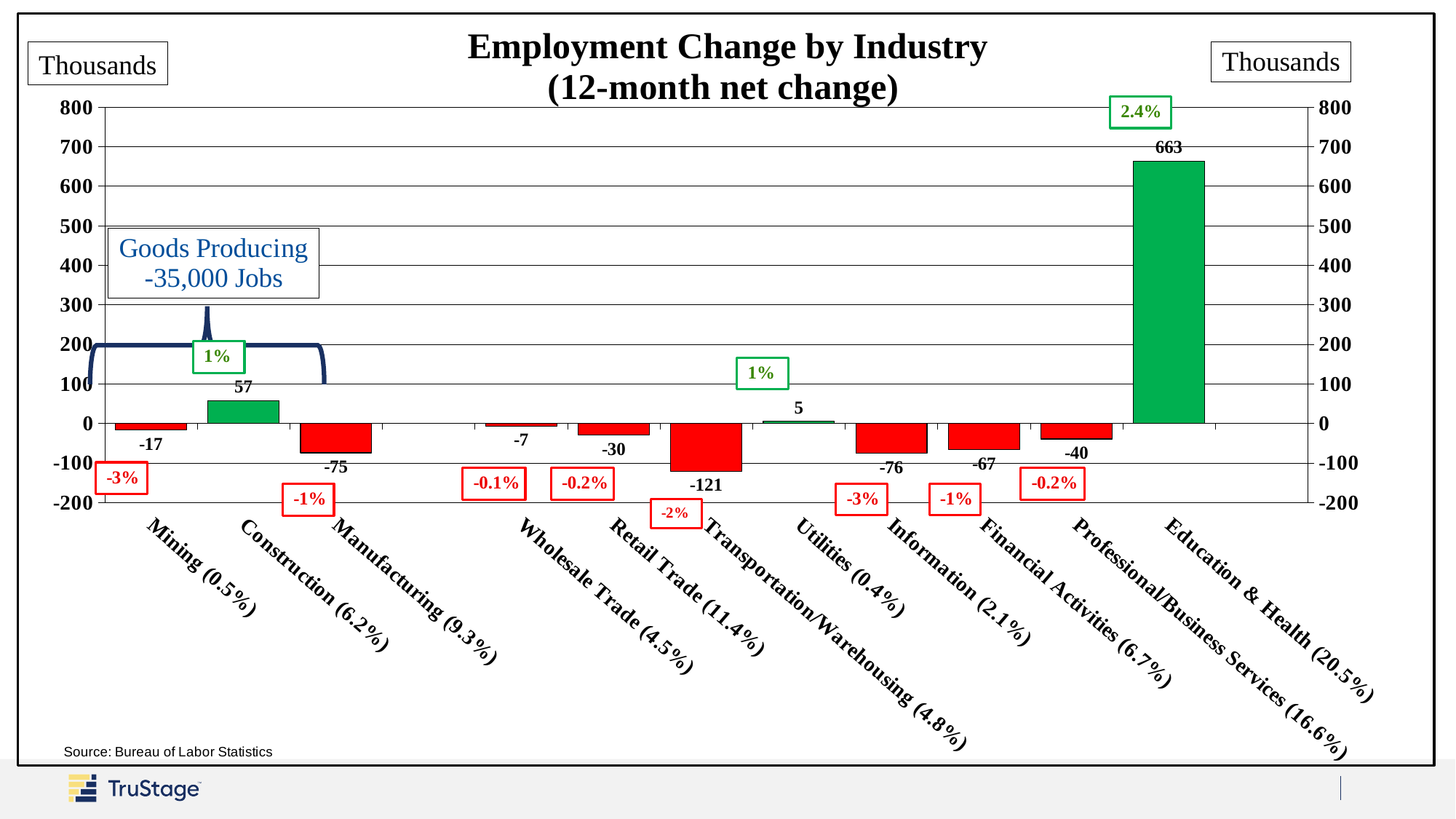
What is the employment change value shown for Education & Health (20.5%)? 663 Is the value for Education & Health (20.5%) greater or less than 600? greater What kind of chart is shown on the slide? Bar chart How many industry categories are plotted on the chart? 11 Which is larger, the value for Information (2.1%) or the value for Financial Activities (6.7%)? Financial Activities (6.7%) What is the employment change value shown for Manufacturing (9.3%)? -75 What is the employment change value shown for Transportation/Warehousing (4.8%)? -121 What is the title of the chart? Employment Change by Industry (12-month net change) What is the difference between the values for Education & Health (20.5%) and Construction (6.2%)? 606 Which industry has the highest employment change? Education & Health (20.5%) Which industry has the lowest employment change? Transportation/Warehousing (4.8%) What is the employment change value shown for Construction (6.2%)? 57